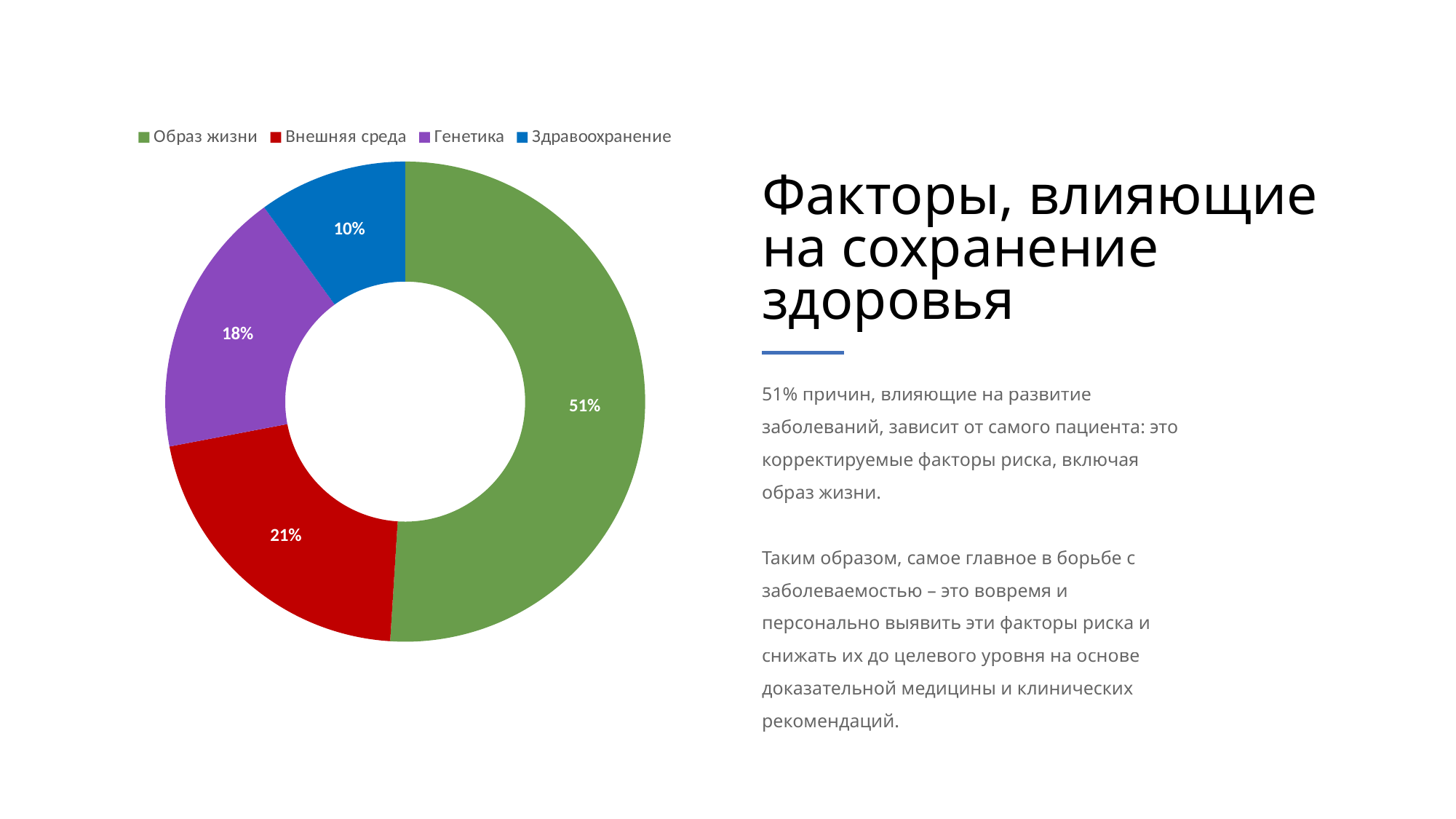
What is the value shown for Генетика? 18% Which category has the smallest slice? Здравоохранение Which category has the largest slice? Образ жизни Which is larger, Внешняя среда or Генетика? Внешняя среда What share of the chart does Образ жизни account for? 51% What kind of chart is shown on the slide? Doughnut (pie) chart What is the difference between the values for Образ жизни and Внешняя среда? 30% What is the value shown for Здравоохранение? 10% What is the difference between the values for Генетика and Здравоохранение? 8% What colour is the slice for Генетика? Purple What is the value shown for Внешняя среда? 21% How many categories does the chart show? 4